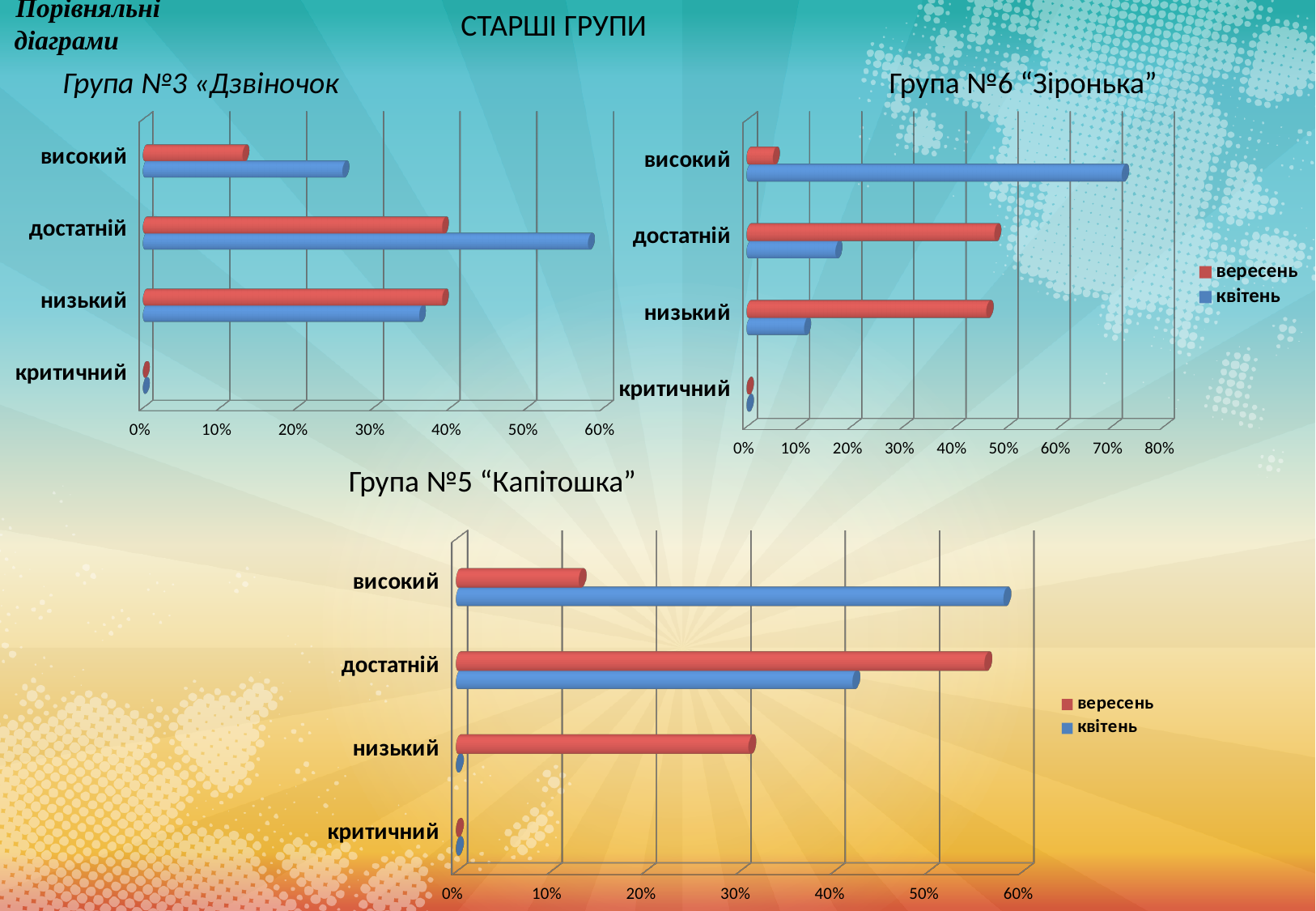
In the chart for Група №5 “Капітошка”, which is larger for високий, the вересень value or the квітень value? квітень In the chart for Група №3 «Дзвіночок», is the квітень value for достатній greater or less than 50%? greater In the chart for Група №3 «Дзвіночок», which category has the highest квітень value? достатній In the chart for Група №3 «Дзвіночок», is the вересень value for високий greater or less than 20%? less In the chart for Група №5 “Капітошка”, is the вересень value for достатній greater or less than 50%? greater What type of chart is used for Група №5 “Капітошка”? bar chart In the chart for Група №6 “Зіронька”, which is larger for достатній, the вересень value or the квітень value? вересень In the chart for Група №6 “Зіронька”, which category has the lowest квітень value? критичний In the chart for Група №6 “Зіронька”, how many series does the legend list? 2 In the chart for Група №3 «Дзвіночок», how many categories are shown on the vertical axis? 4 In the chart for Група №5 “Капітошка”, which category has the highest вересень value? достатній